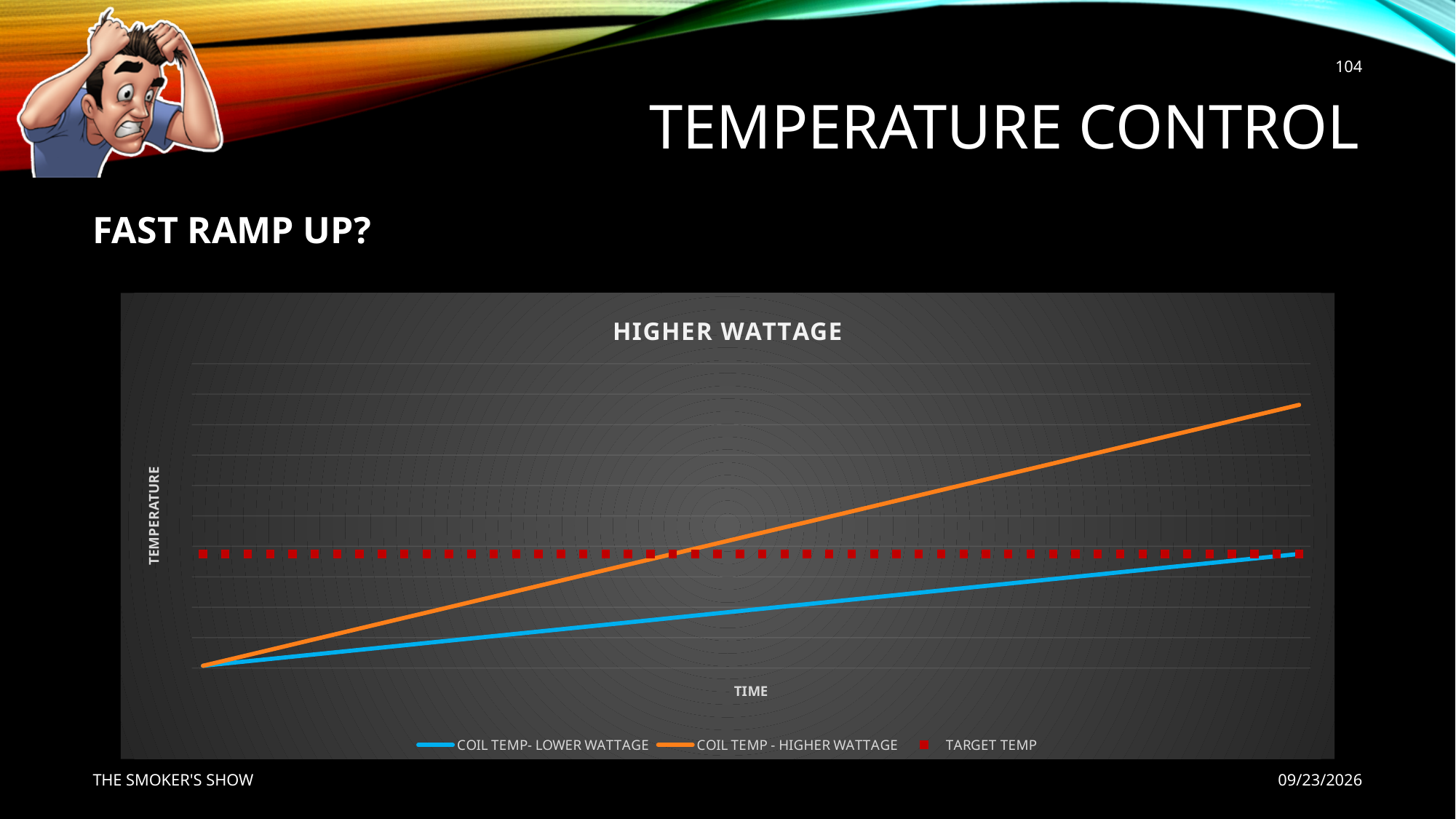
At the midpoint of the time axis, is the COIL TEMP- LOWER WATTAGE line above or below the TARGET TEMP line? Below Which series reaches the highest temperature at the end of the time axis? COIL TEMP - HIGHER WATTAGE At the right end of the chart, which series is higher: COIL TEMP - HIGHER WATTAGE or COIL TEMP- LOWER WATTAGE? COIL TEMP - HIGHER WATTAGE Does the COIL TEMP - HIGHER WATTAGE line rise or fall along the time axis? Rise What kind of chart is shown on the slide? Line chart Does the COIL TEMP- LOWER WATTAGE line rise or fall along the time axis? Rise How many series does the legend of the chart list? 3 What is the title of the chart? HIGHER WATTAGE Which of the two coil temperature lines crosses the TARGET TEMP line first? COIL TEMP - HIGHER WATTAGE Does the TARGET TEMP series rise, fall, or stay flat along the time axis? Stay flat What is the label on the vertical axis of the chart? TEMPERATURE